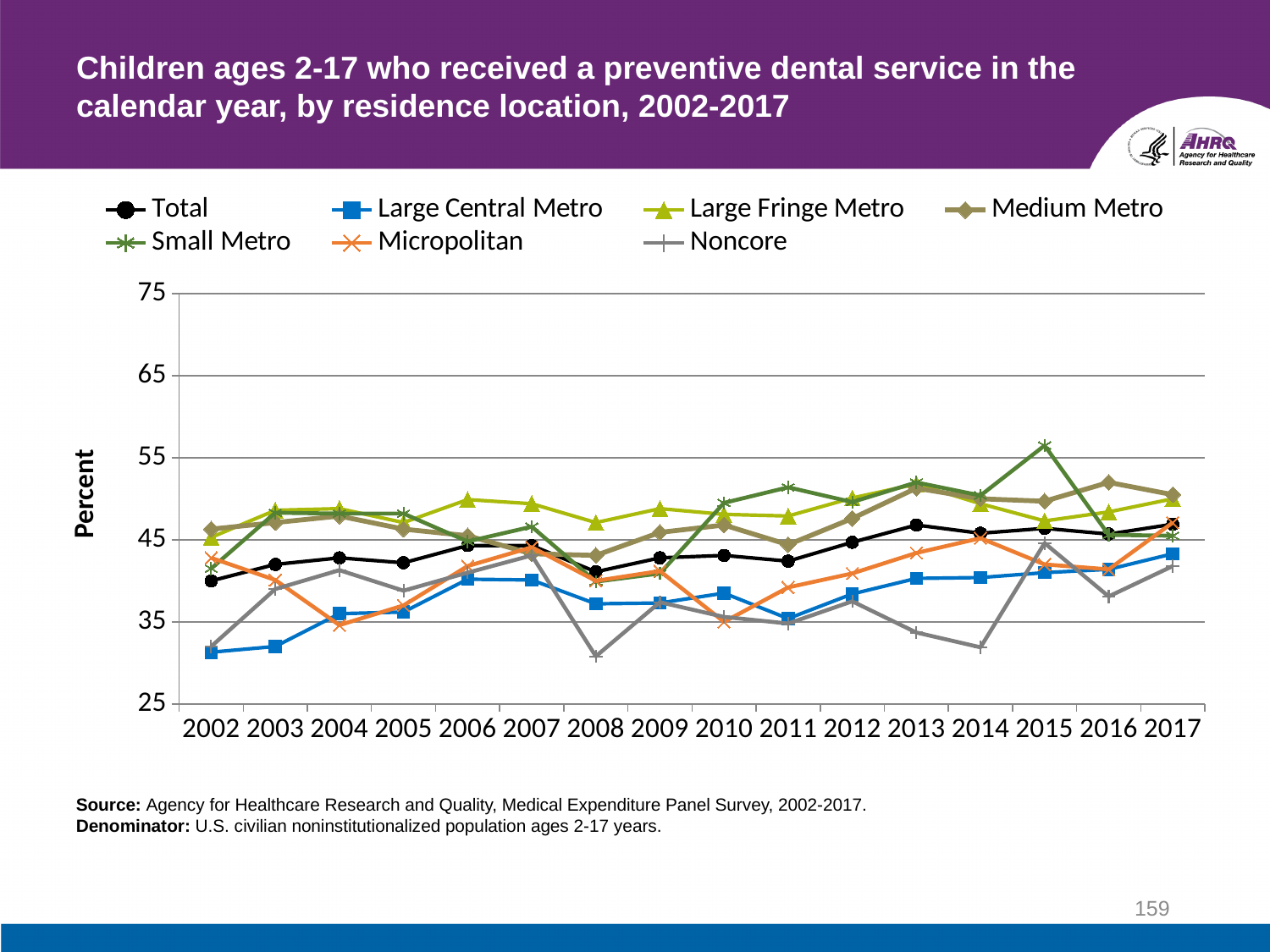
Is the value for Medium Metro in 2016 greater or less than 45? greater How many years are plotted along the x axis? 16 What kind of chart is shown on the slide? line chart In 2002, which is larger: Large Fringe Metro or Large Central Metro? Large Fringe Metro Which residence location has the highest value in 2015? Small Metro Is the value for Small Metro in 2015 greater or less than 55? greater Is the value for Noncore in 2008 greater or less than 35? less Which residence location has the lowest value in 2014? Noncore What is the label on the vertical axis? Percent How many series does the legend list? 7 Does the Large Central Metro line rise or fall overall from 2002 to 2017? rise